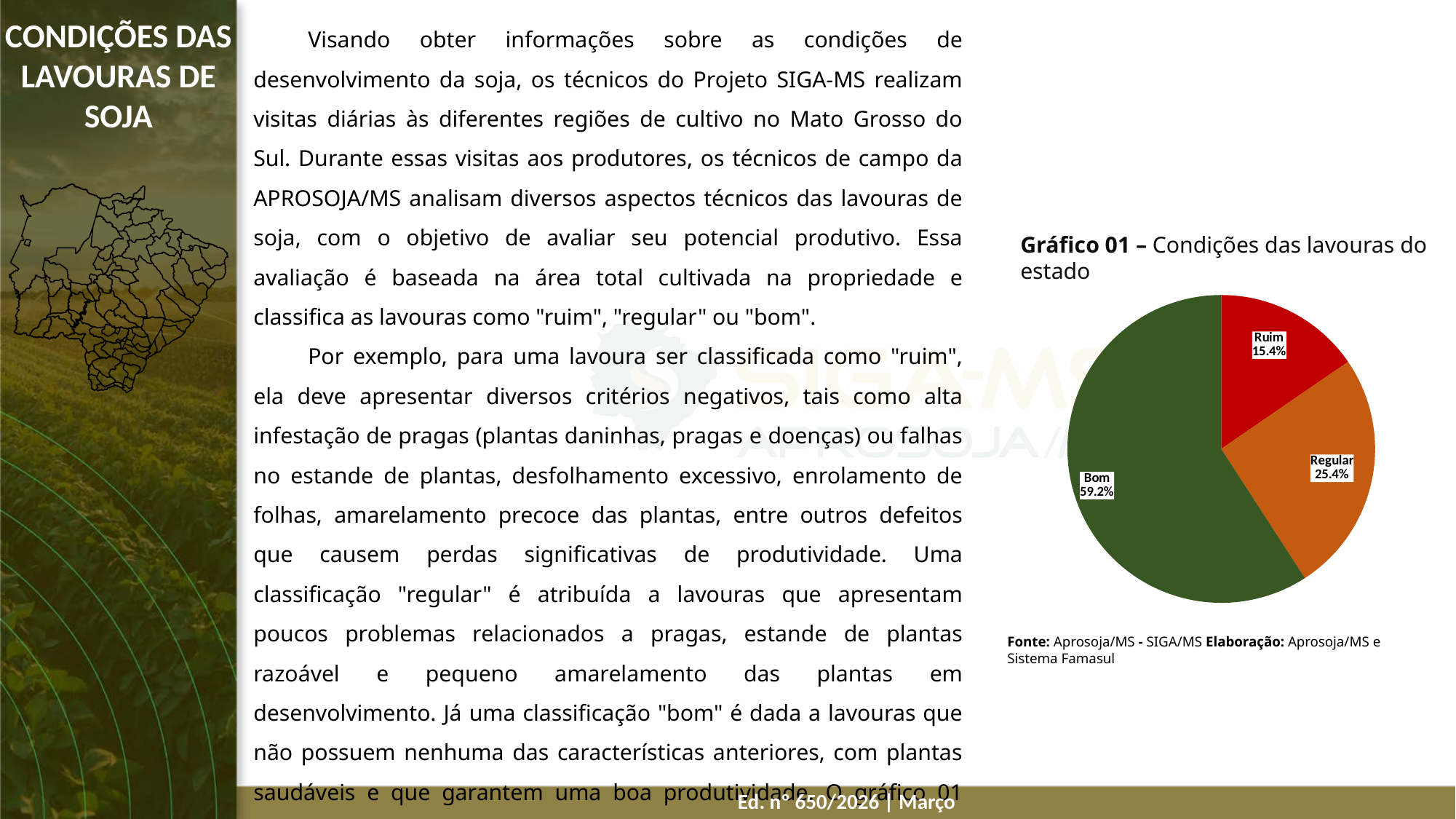
What is the value shown for Regular? 25.4% What is the title of the chart? Gráfico 01 – Condições das lavouras do estado What type of chart is Gráfico 01? pie chart What is the value shown for Ruim? 15.4% What colour is the Bom slice? dark green Which is larger, the Regular slice or the Ruim slice? Regular Which category has the smallest slice of the pie? Ruim Which category has the largest slice of the pie? Bom What is the difference between the Regular and Ruim percentages? 10.0% What is the difference between the Bom and Regular percentages? 33.8% What share of the pie does the Bom slice represent? 59.2% How many categories are shown in the pie chart? 3